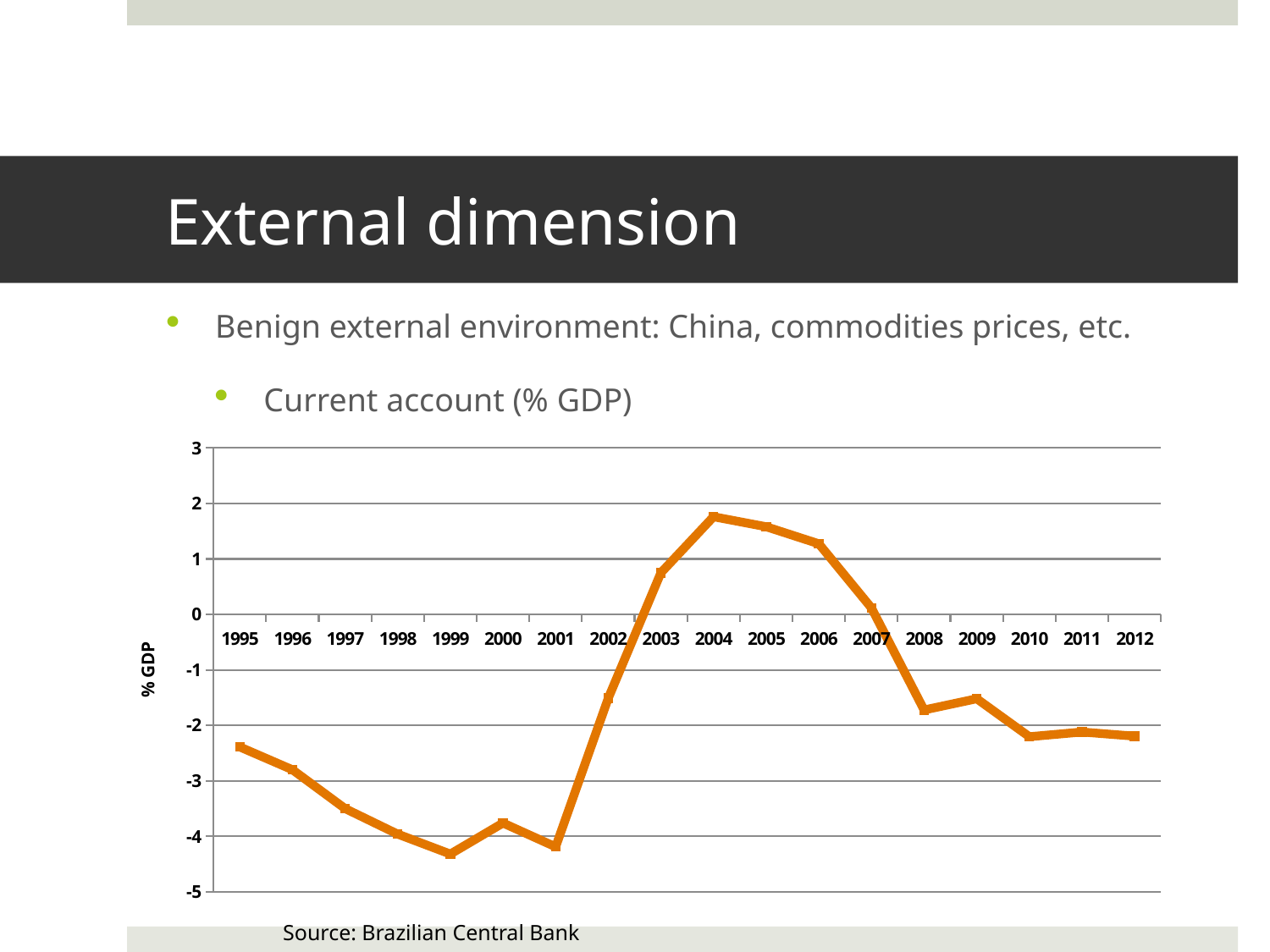
How many years are plotted on the x axis of the chart? 18 Is the value for 2004 greater or less than 1? greater What is the label on the vertical axis of the chart? % GDP Is the value for 1999 greater or less than -4? less Is the value for 2002 greater or less than -1? less In which year does the current account reach its highest value? 2004 Do the values rise or fall from 2004 to 2008? fall Which year has the larger current account value, 1997 or 2003? 2003 What kind of chart is shown on the slide? line chart In which year does the current account reach its lowest value? 1999 Which year has the larger current account value, 2006 or 2010? 2006